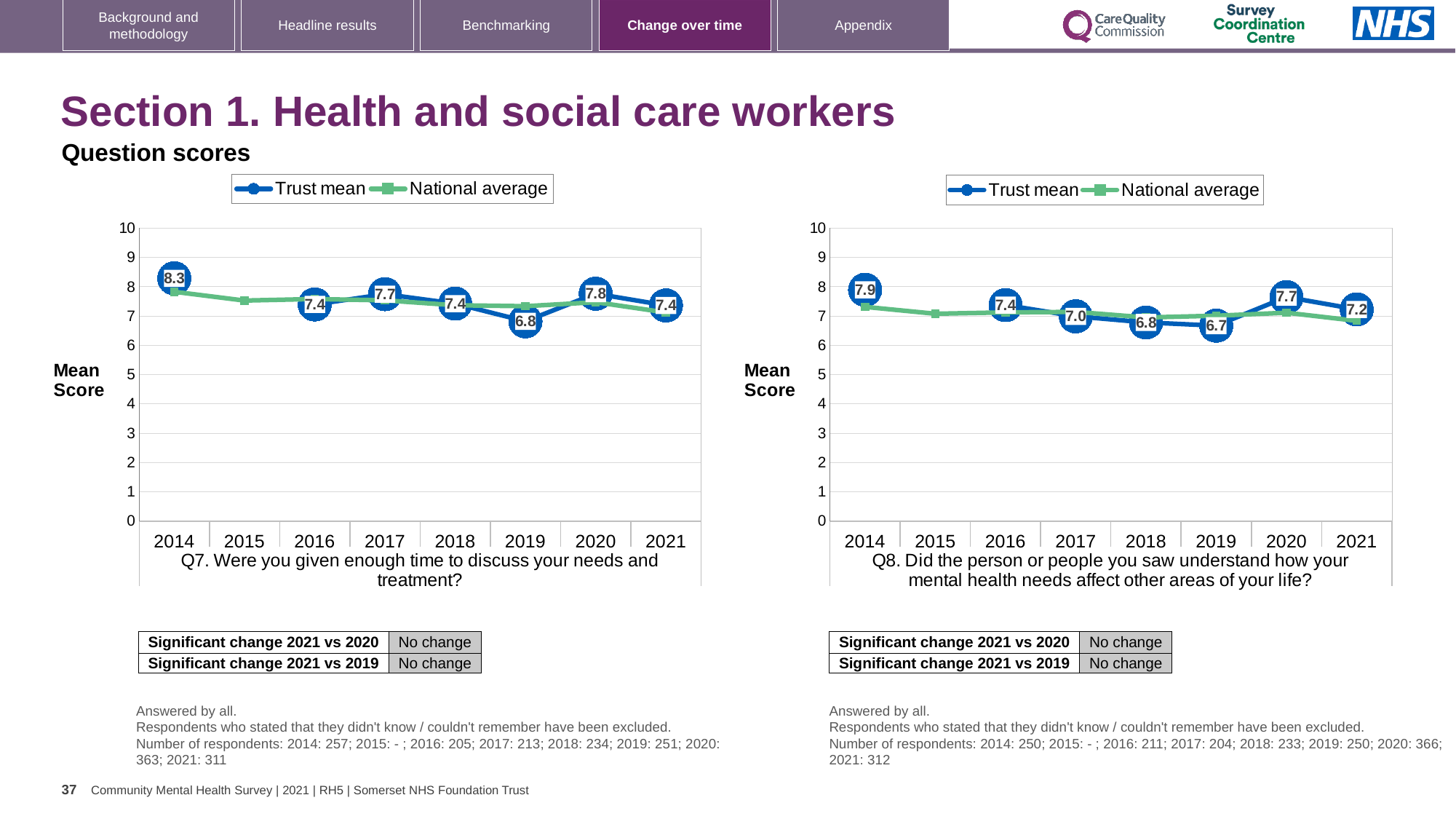
In the Q7 chart on the left, is the National average for 2015 greater or less than 7? greater In the Q8 chart on the right, which year has the lowest Trust mean? 2019 In the Q7 chart on the left, what is the difference between the Trust mean in 2020 and in 2019? 1.0 How many series does the legend of the Q7 chart on the left list? 2 What kind of chart is the Q8 chart on the right? Line chart In the Q7 chart on the left, what is the Trust mean for 2019? 6.8 In the Q7 chart on the left, which year has the highest Trust mean? 2014 In the Q7 chart on the left, what is the Trust mean for 2014? 8.3 In the Q8 chart on the right, what is the Trust mean for 2021? 7.2 In the Q8 chart on the right, which is larger: the Trust mean in 2017 or in 2020? 2020 In the Q8 chart on the right, what is the difference between the Trust mean in 2014 and in 2021? 0.7 In the Q8 chart on the right, what is the Trust mean for 2020? 7.7